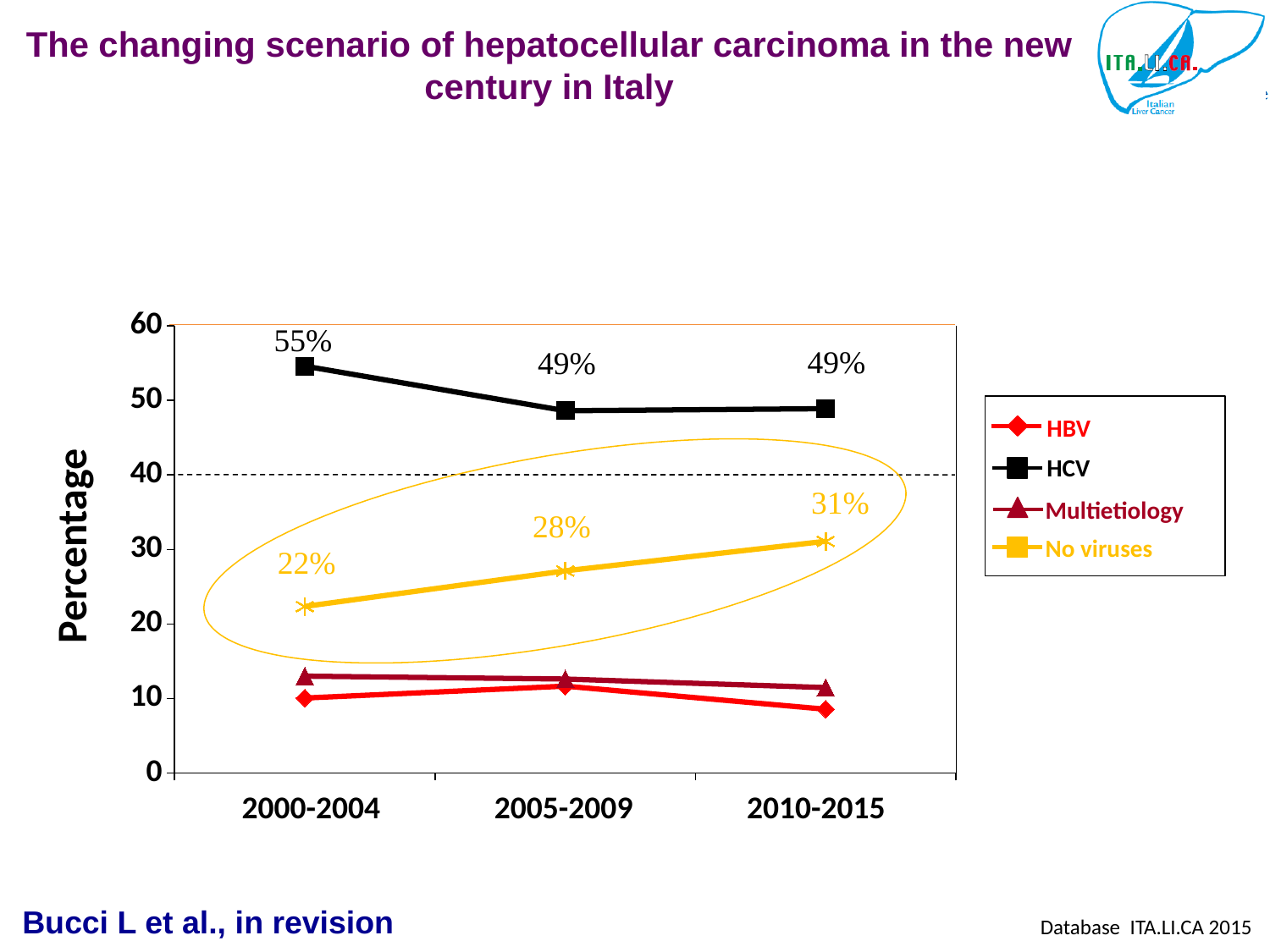
What is the HCV value for 2010-2015? 49% Does the No viruses series rise or fall across the periods from 2000-2004 to 2010-2015? rise What is the No viruses value for 2005-2009? 28% By how many percentage points did the No viruses value change from 2000-2004 to 2010-2015? 9 What is the HCV value for 2000-2004? 55% What is the difference between the HCV value in 2000-2004 and in 2005-2009? 6 What is the No viruses value for 2010-2015? 31% Is the HBV value for 2010-2015 greater or less than 10? less What type of chart is shown on the slide? line chart How many time periods are shown on the x axis? 3 Which series has the highest value in 2010-2015? HCV How many series does the legend list? 4